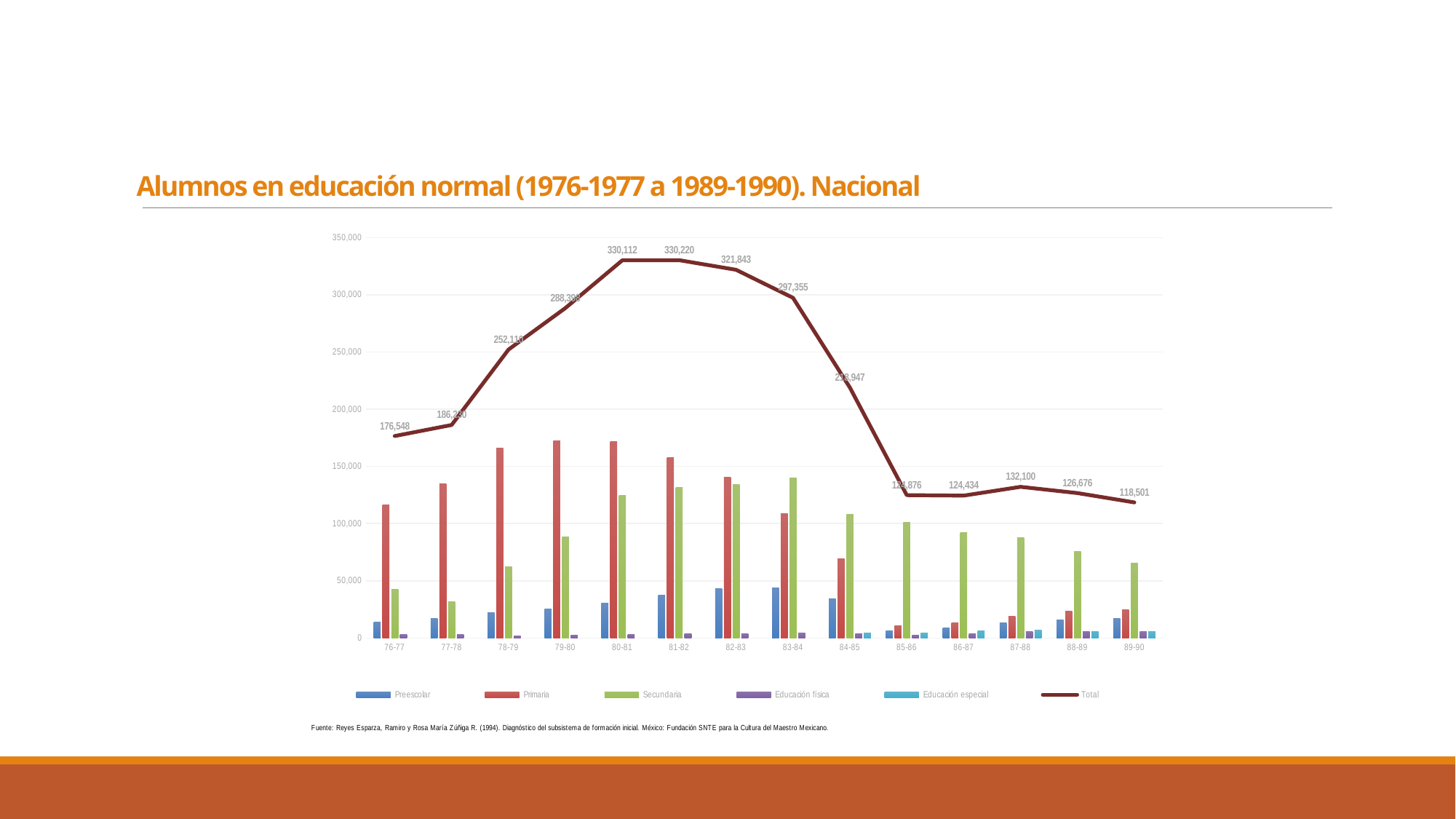
In which school year is the Total highest? 81-82 Is the value for Primaria in 79-80 greater or less than 150,000? greater What is the Total value for 76-77? 176,548 What is the difference between the Total for 81-82 and the Total for 80-81? 108 How many school years are shown on the x axis? 14 What is the difference between the Total for 87-88 and the Total for 88-89? 5,424 Which is larger, the Total for 82-83 or the Total for 83-84? 82-83 Is the value for Secundaria in 83-84 greater or less than 100,000? greater What is the Total value for 87-88? 132,100 In which school year is the Total lowest? 89-90 How many series does the legend list? 6 What is the Total value for 89-90? 118,501